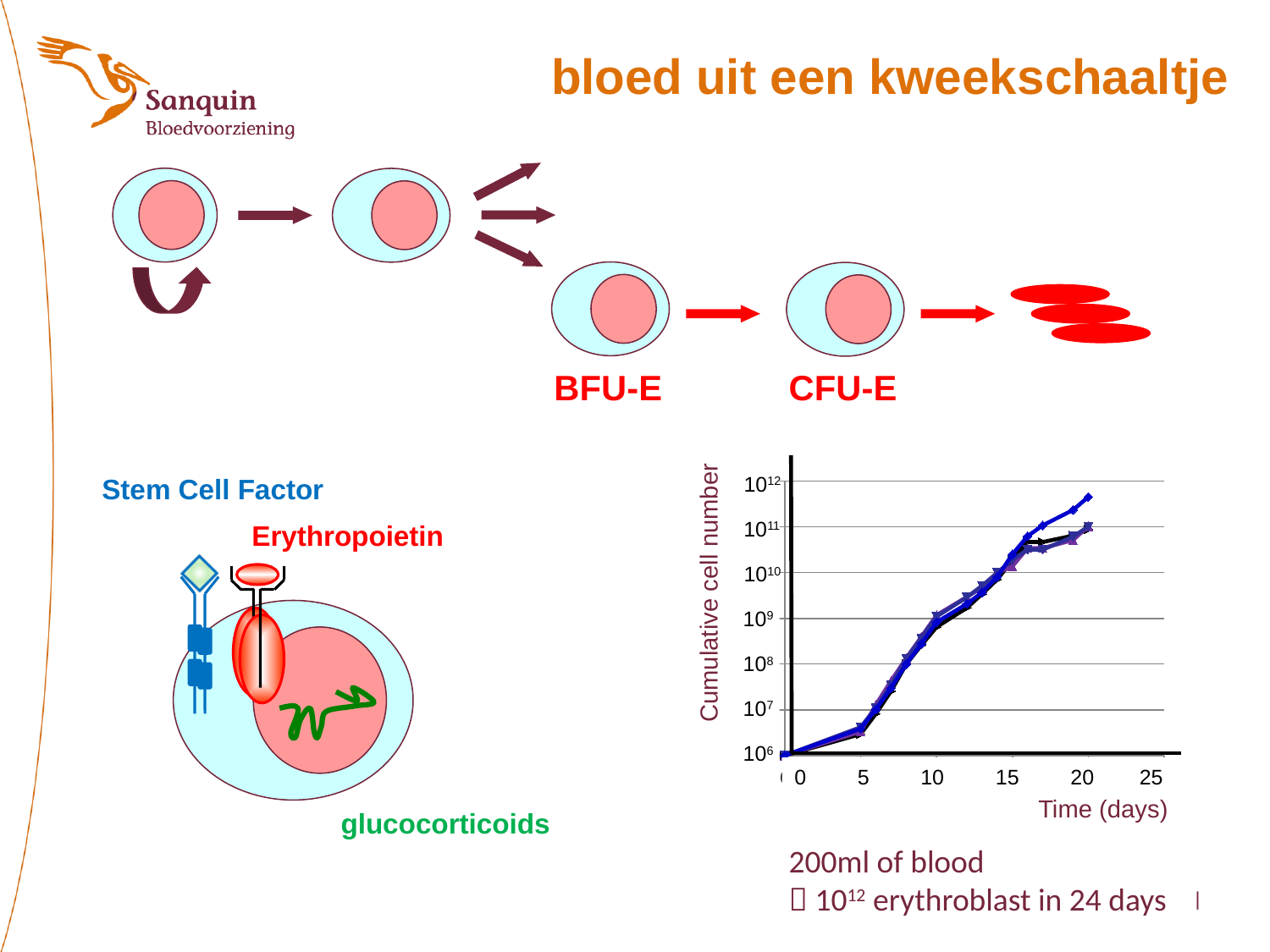
Is the cumulative cell number at day 5 greater or less than 10⁷? less What is the cumulative cell number at day 0? 10⁶ How many lines are plotted on the chart? 4 Which line reaches the highest cumulative cell number at the end of the time course? the blue line Is the cumulative cell number at day 20 greater or less than 10¹²? less What is the label of the y axis of the chart? Cumulative cell number Is the cumulative cell number at day 15 greater or less than 10⁹? greater Does the cumulative cell number rise or fall as time increases? rise What is the label of the x axis of the chart? Time (days) What kind of chart is shown on the slide? line chart